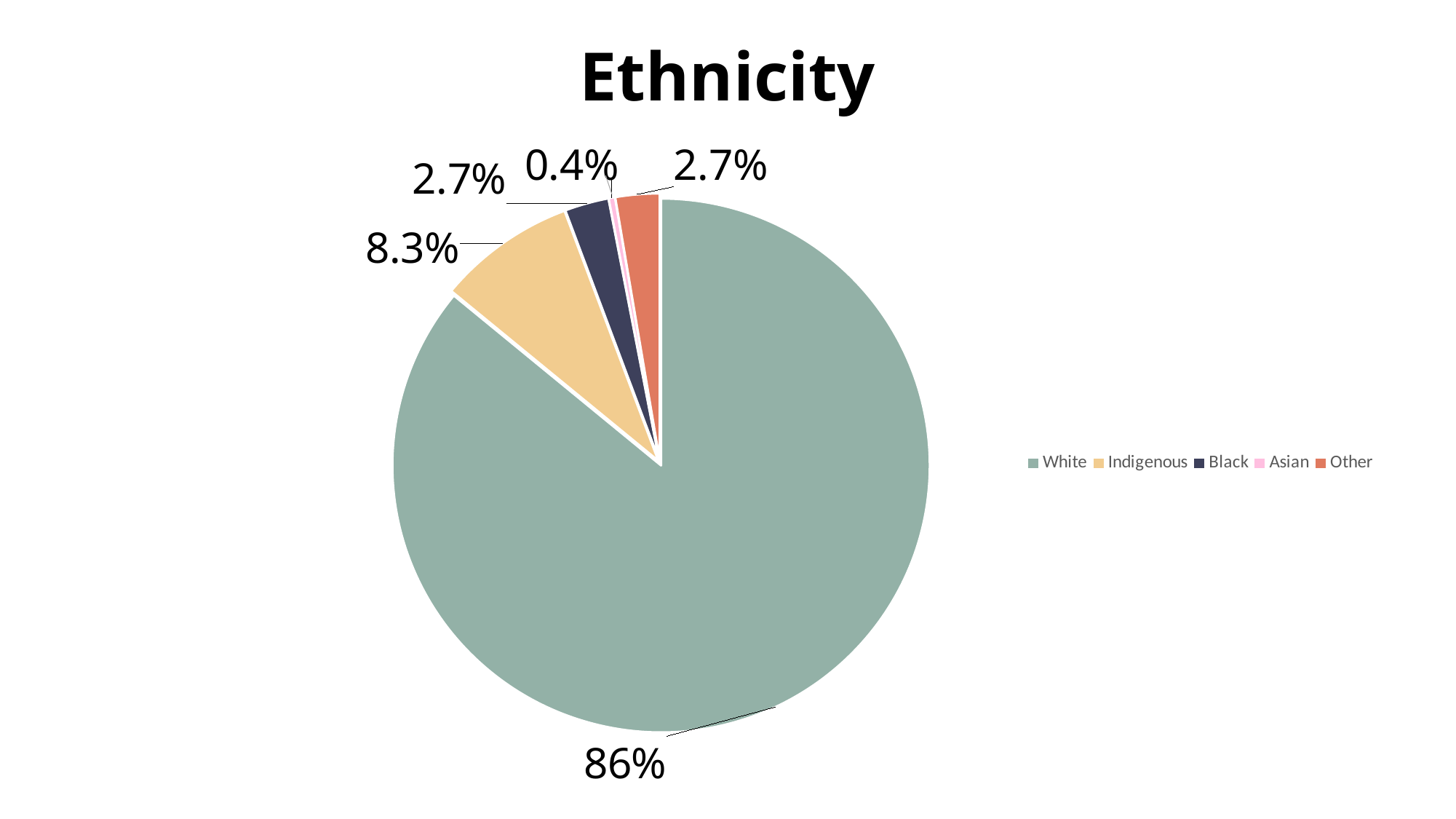
Which is larger, the Indigenous share or the Other share? Indigenous What is the title of the chart? Ethnicity What kind of chart is shown on the slide? Pie chart How many categories does the pie chart show? 5 What is the difference between the White and Indigenous shares? 77.7% What is the difference between the Indigenous and Black shares? 5.6% Which category has the largest slice? White What is the value for Indigenous? 8.3% What share of the pie does White represent? 86% What is the value for Asian? 0.4% What is the value for Black? 2.7% Which category has the smallest slice? Asian